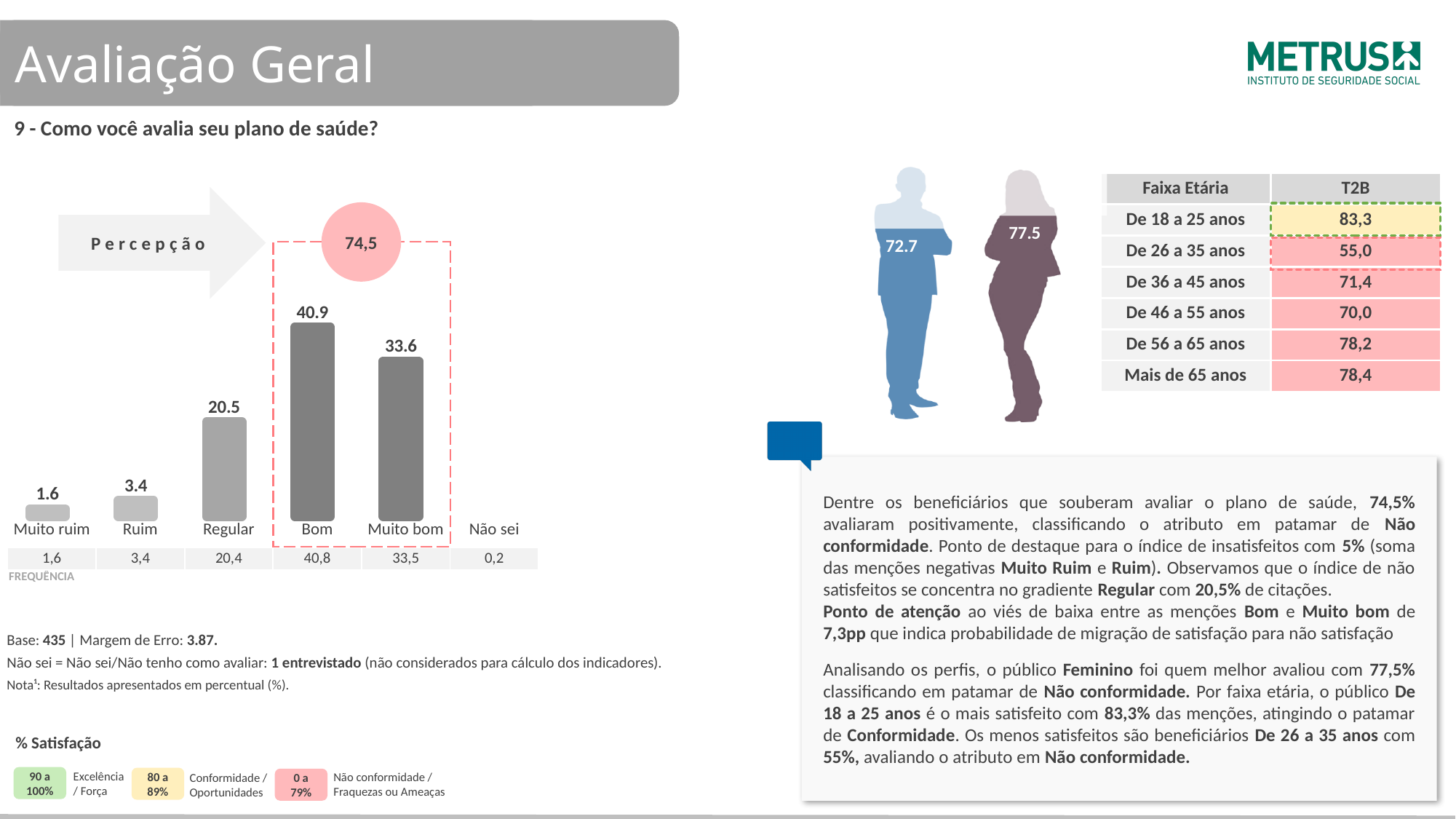
Which is larger, the value for 'Regular' or the value for 'Ruim'? Regular How many categories are labeled along the x axis of the bar chart? 6 What is the value shown for the 'Muito bom' bar? 33.6 What value is shown in the pink circle above the 'Bom' and 'Muito bom' bars? 74,5 What is the value shown for the 'Bom' bar? 40.9 Which category has the highest bar in the chart? Bom What is the difference between the 'Bom' and 'Muito bom' values? 7.3 What type of chart is used to show the evaluation of the health plan? bar chart What is the value shown for the 'Regular' bar? 20.5 What is the value shown for the 'Muito ruim' bar? 1.6 Among the bars shown, which category has the lowest value? Muito ruim What is the value shown for the 'Ruim' bar? 3.4